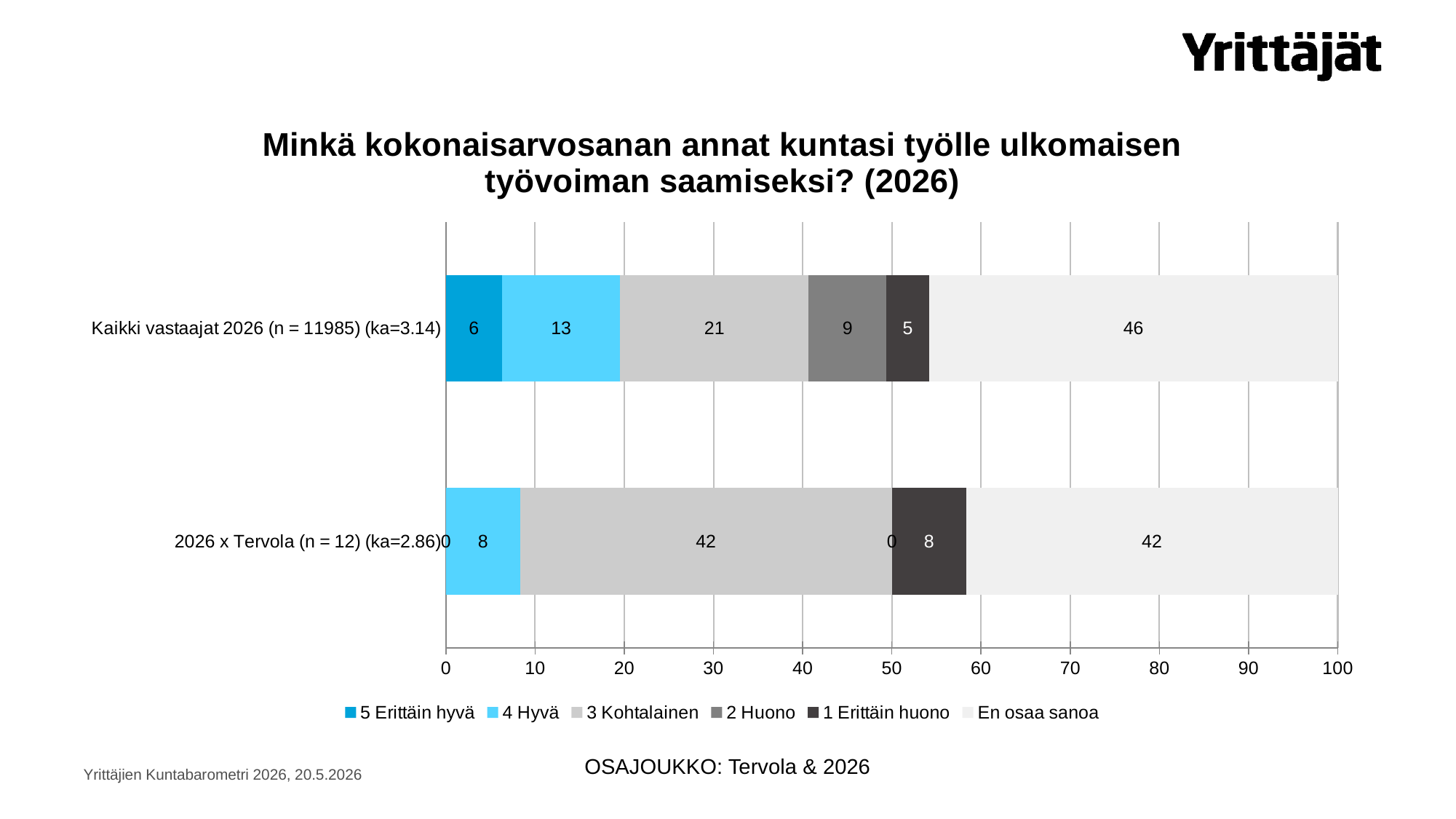
What is the title of the chart? Minkä kokonaisarvosanan annat kuntasi työlle ulkomaisen työvoiman saamiseksi? (2026) How many series does the legend list? 6 Which is larger: the "4 Hyvä" value for "Kaikki vastaajat 2026 (n = 11985) (ka=3.14)" or for "2026 x Tervola (n = 12) (ka=2.86)"? Kaikki vastaajat 2026 (n = 11985) (ka=3.14) How many categories (bars) are shown in the chart? 2 What is the value of "En osaa sanoa" for "Kaikki vastaajat 2026 (n = 11985) (ka=3.14)"? 46 What is the value of "2 Huono" for "Kaikki vastaajat 2026 (n = 11985) (ka=3.14)"? 9 Which segment is the largest in the "Kaikki vastaajat 2026 (n = 11985) (ka=3.14)" bar? En osaa sanoa What is the value of "5 Erittäin hyvä" for "2026 x Tervola (n = 12) (ka=2.86)"? 0 What is the total of the stacked bar for "2026 x Tervola (n = 12) (ka=2.86)"? 100 What kind of chart is shown on the slide? Stacked bar chart What is the difference between the "3 Kohtalainen" values for "2026 x Tervola (n = 12) (ka=2.86)" and "Kaikki vastaajat 2026 (n = 11985) (ka=3.14)"? 21 What is the value of "3 Kohtalainen" for "2026 x Tervola (n = 12) (ka=2.86)"? 42